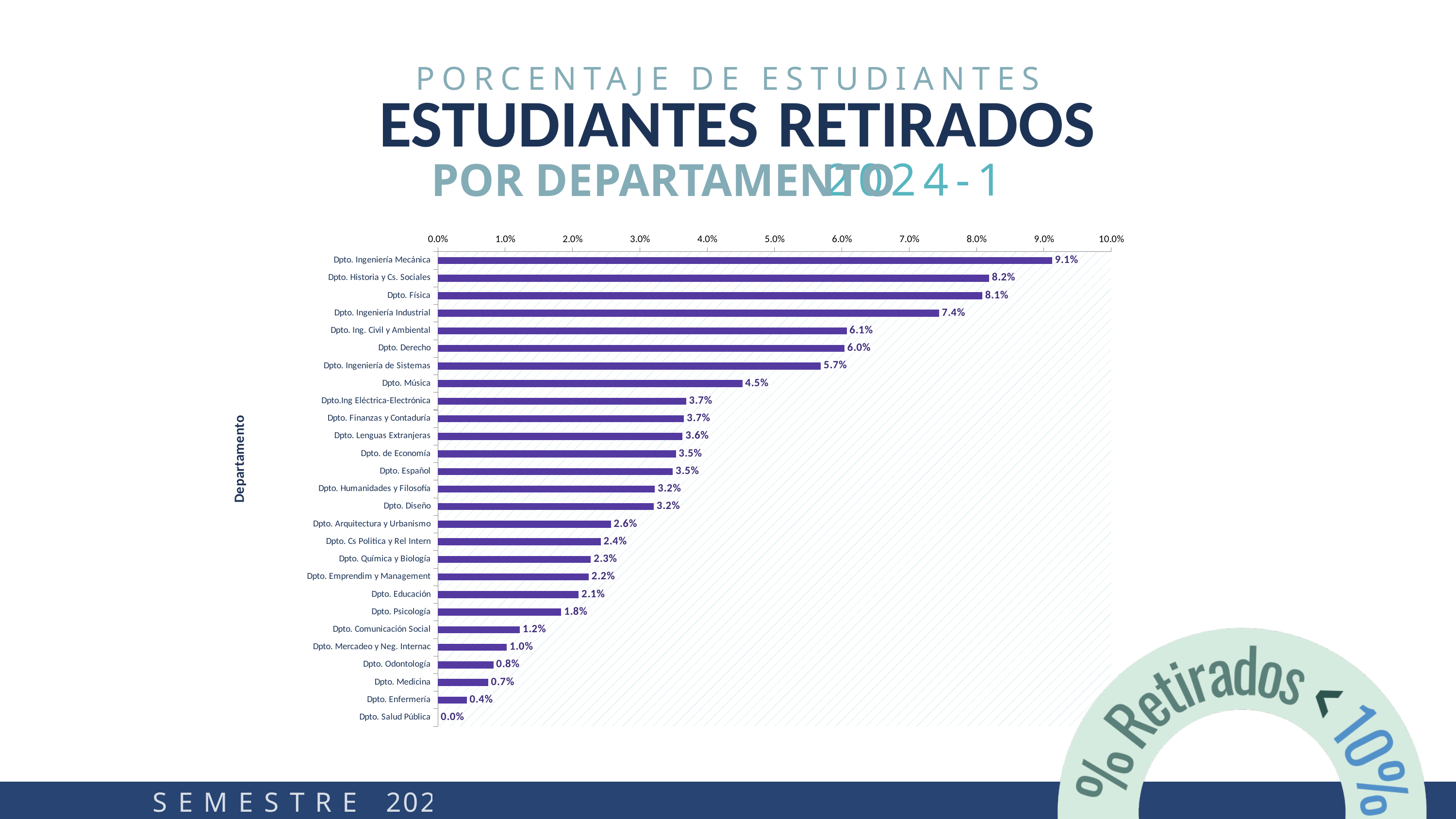
What is the difference between the values for Dpto. Historia y Cs. Sociales and Dpto. Física? 0.1% How many departments are shown in the chart? 27 What is the label of the vertical axis of the chart? Departamento What is the difference between the values for Dpto. Ingeniería Industrial and Dpto. Ingeniería de Sistemas? 1.7% What is the value for Dpto. Música? 4.5% What is the value for Dpto. Psicología? 1.8% What is the value for Dpto. Derecho? 6.0% What is the value for Dpto. Ingeniería Mecánica? 9.1% Which department has the lowest percentage of withdrawn students? Dpto. Salud Pública What kind of chart is shown on the slide? Bar chart Which department has the highest percentage of withdrawn students? Dpto. Ingeniería Mecánica Which is larger, the value for Dpto. Ing. Civil y Ambiental or the value for Dpto. Música? Dpto. Ing. Civil y Ambiental